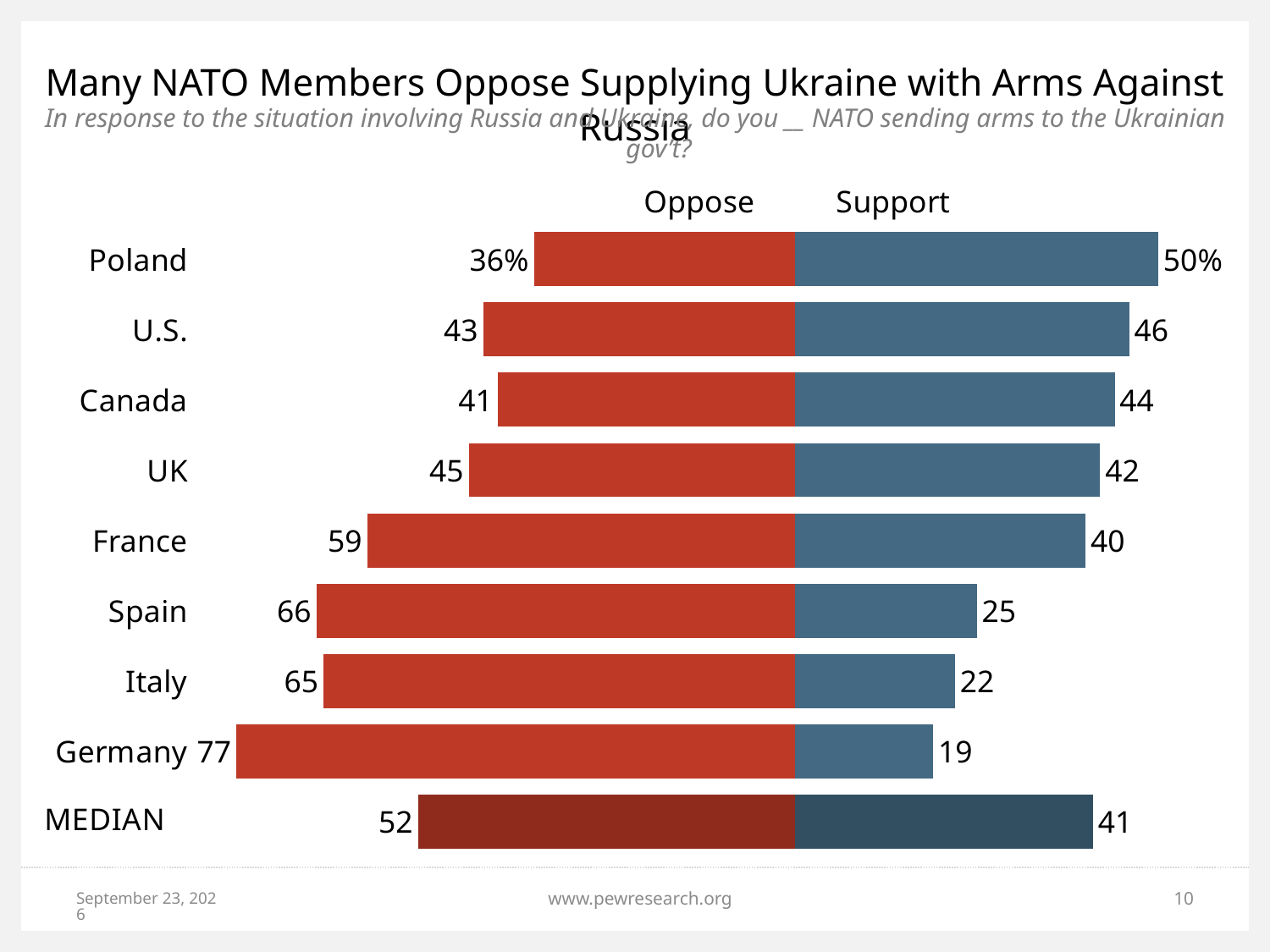
What is the difference between the Oppose and Support values for Germany? 58 What percentage of respondents in Poland oppose NATO sending arms to the Ukrainian government? 36% Which country has the highest Oppose value? Germany How many countries are shown on the chart, excluding the MEDIAN row? 8 Which country has the lowest Support value? Germany For France, which is larger: the Oppose value or the Support value? Oppose What is the MEDIAN Oppose value shown on the chart? 52 What is the Support value for Spain? 25 What is the Support value for Germany? 19 How many series does the chart show? 2 What type of chart is shown on the slide? Bar chart Which country has the highest Support value? Poland